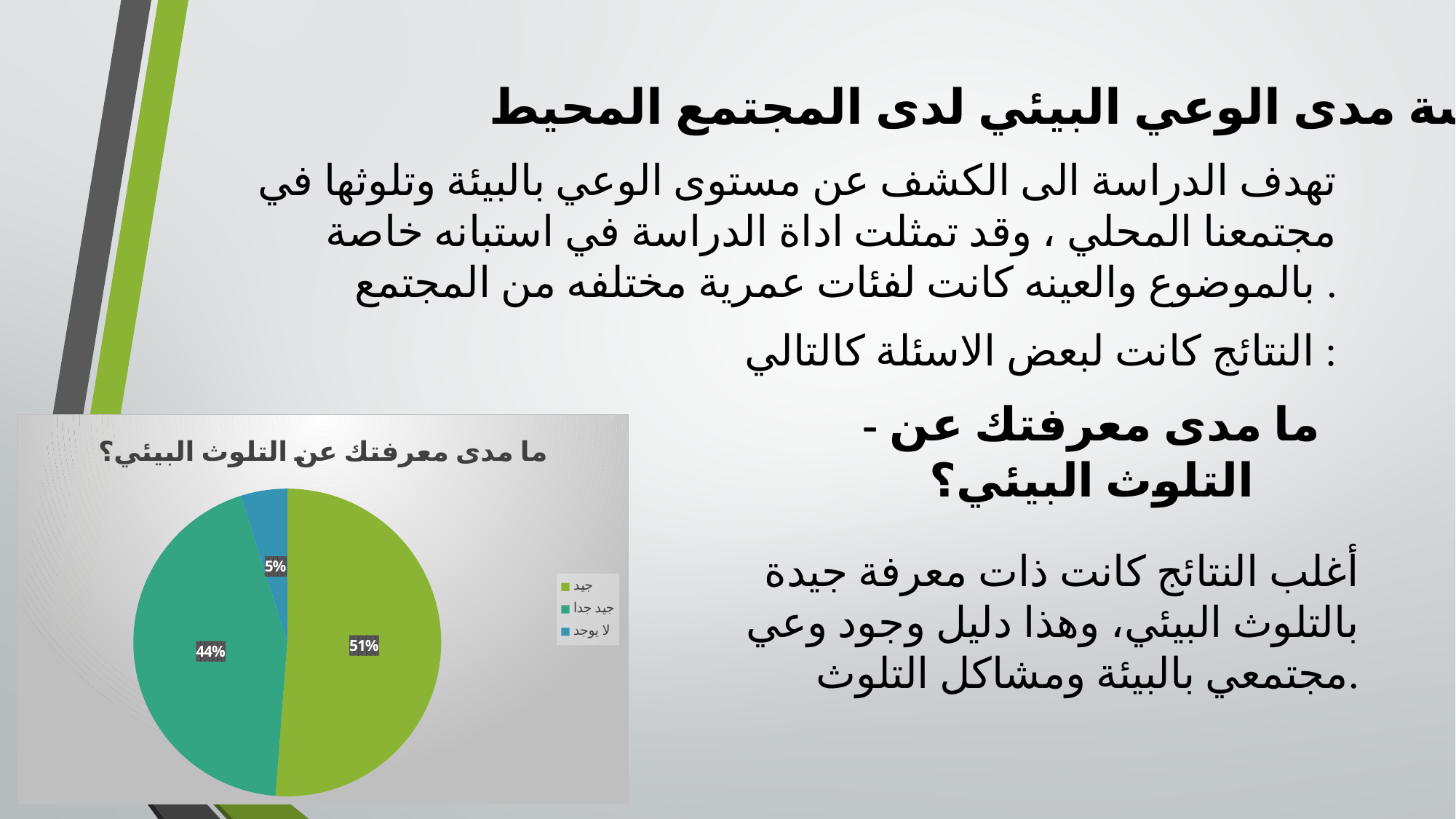
Which category has the smallest slice of the pie? لا يوجد What is the difference in percentage points between the جيد slice and the جيد جدا slice? 7 What is the title of the pie chart? ما مدى معرفتك عن التلوث البيئي؟ What type of chart is shown on the slide? pie chart Which category has the largest slice of the pie? جيد What percentage of the pie is the slice for جيد جدا? 44% How many slices does the pie chart have? 3 Which slice is larger, جيد جدا or لا يوجد? جيد جدا What percentage of the pie is the slice for جيد? 51% What colour is the slice for لا يوجد? blue What percentage of the pie is the slice for لا يوجد? 5% How many entries does the legend list? 3